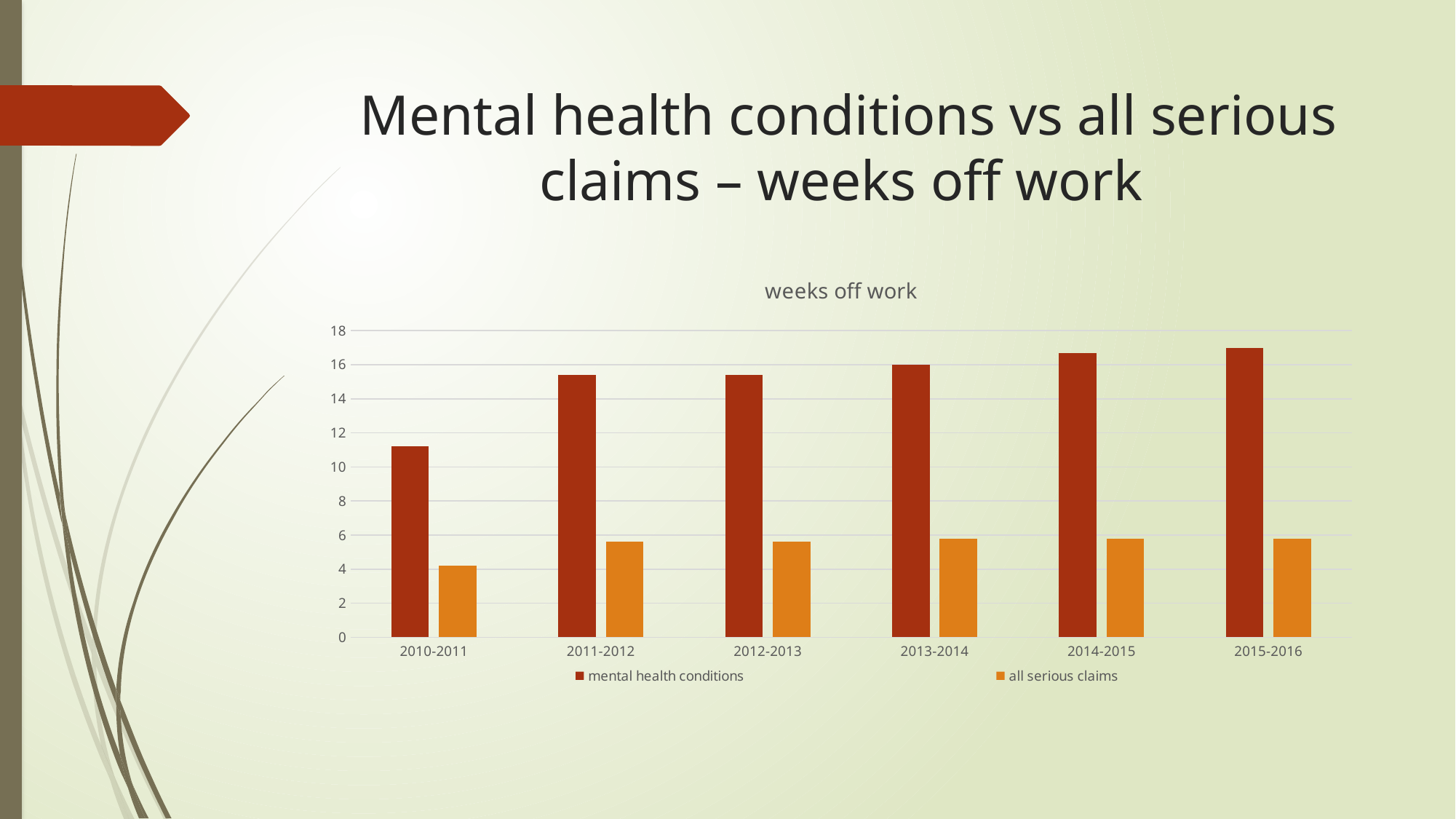
Which series is shown in dark red in the chart? mental health conditions Is the value for mental health conditions in 2015-2016 greater or less than 16? greater Is the value for mental health conditions in 2010-2011 greater or less than 12? less Is the value for all serious claims in 2010-2011 greater or less than 6? less How many year periods are shown on the x axis of the chart? 6 In 2013-2014, which is larger: mental health conditions or all serious claims? mental health conditions Do the values for mental health conditions generally rise or fall from 2010-2011 to 2015-2016? rise What kind of chart is shown on the slide? bar chart What is the title printed above the chart's plot area? weeks off work Which year period has the lowest value for mental health conditions? 2010-2011 How many series does the chart's legend list? 2 Which year period has the lowest value for all serious claims? 2010-2011